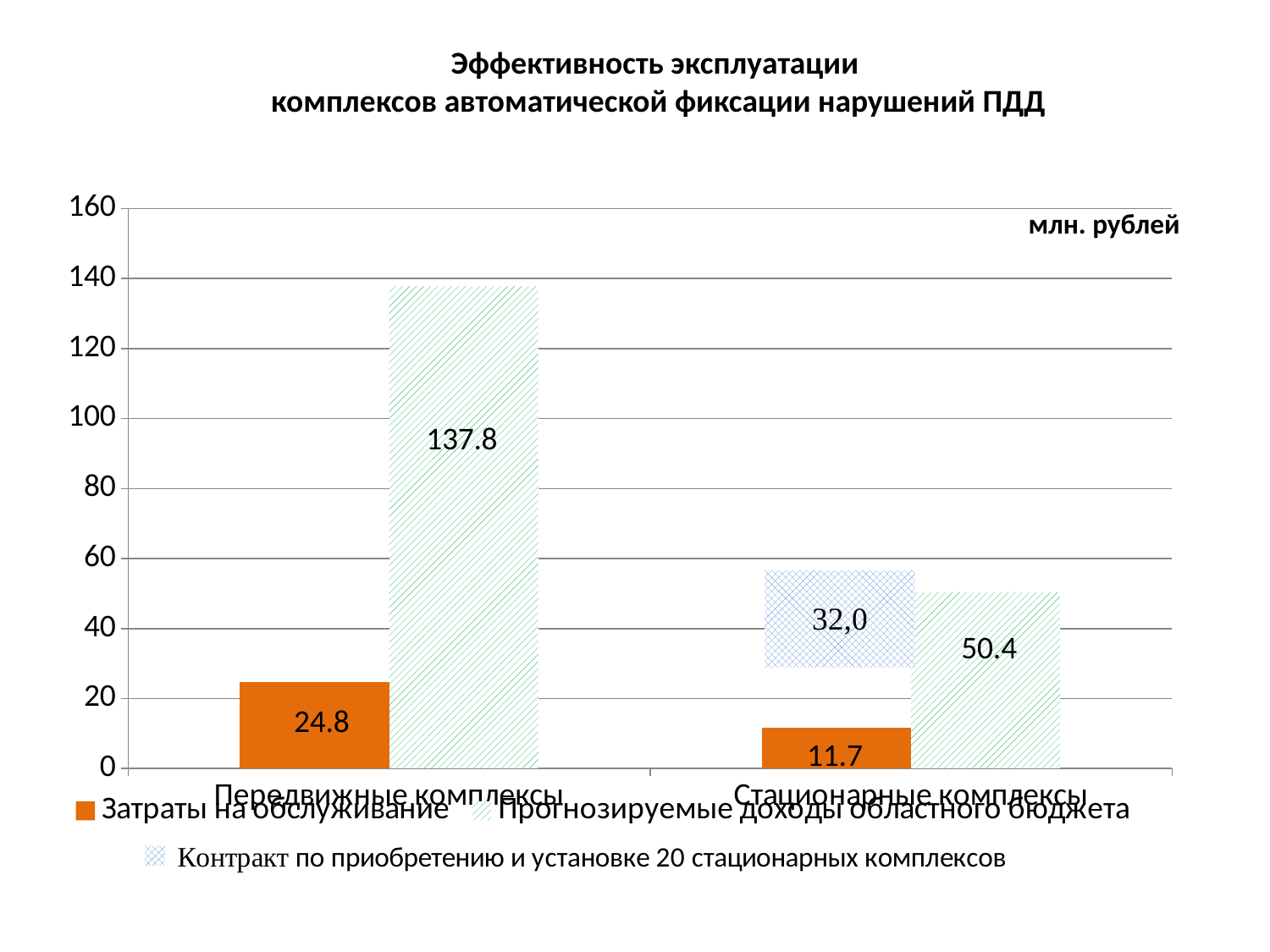
Which category has the higher value for Прогнозируемые доходы областного бюджета? Передвижные комплексы Which category has the lower value for Затраты на обслуживание? Стационарные комплексы Is Затраты на обслуживание larger for Передвижные комплексы or for Стационарные комплексы? Передвижные комплексы How many series does the legend list? 3 What is the value of Прогнозируемые доходы областного бюджета for Передвижные комплексы? 137.8 What is the difference between Прогнозируемые доходы областного бюджета and Затраты на обслуживание for Передвижные комплексы? 113.0 How many categories are shown on the x axis? 2 What is the value of Затраты на обслуживание for Передвижные комплексы? 24.8 What unit is indicated on the chart? млн. рублей What is the difference between Прогнозируемые доходы областного бюджета and Затраты на обслуживание for Стационарные комплексы? 38.7 What is the value of Прогнозируемые доходы областного бюджета for Стационарные комплексы? 50.4 What is the value of Затраты на обслуживание for Стационарные комплексы? 11.7